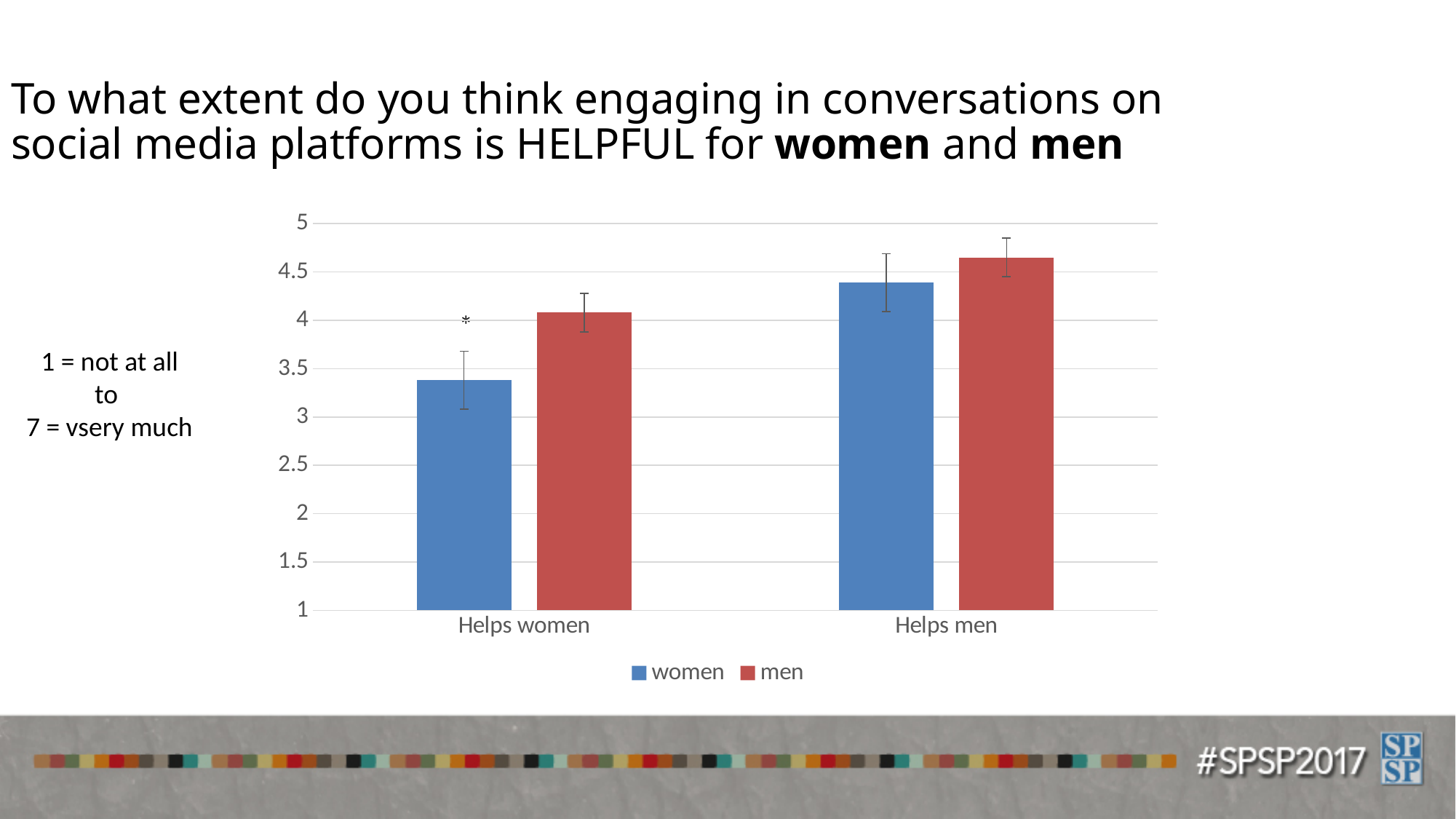
For the 'Helps men' category, which series has the larger value, women or men? men Which series and category combination has the shortest bar in the chart? women, Helps women How many series does the chart's legend list? 2 What colour are the bars for the men series in the chart? red Is the value for the men series in the 'Helps men' category greater or less than 4.5? greater For the 'Helps women' category, which series has the larger value, women or men? men How many categories are shown on the x axis of the chart? 2 Is the value for the women series in the 'Helps men' category greater or less than 4? greater What kind of chart is shown on the slide? bar chart Is the value for the men series in the 'Helps women' category greater or less than 4.5? less Which series and category combination has the tallest bar in the chart? men, Helps men